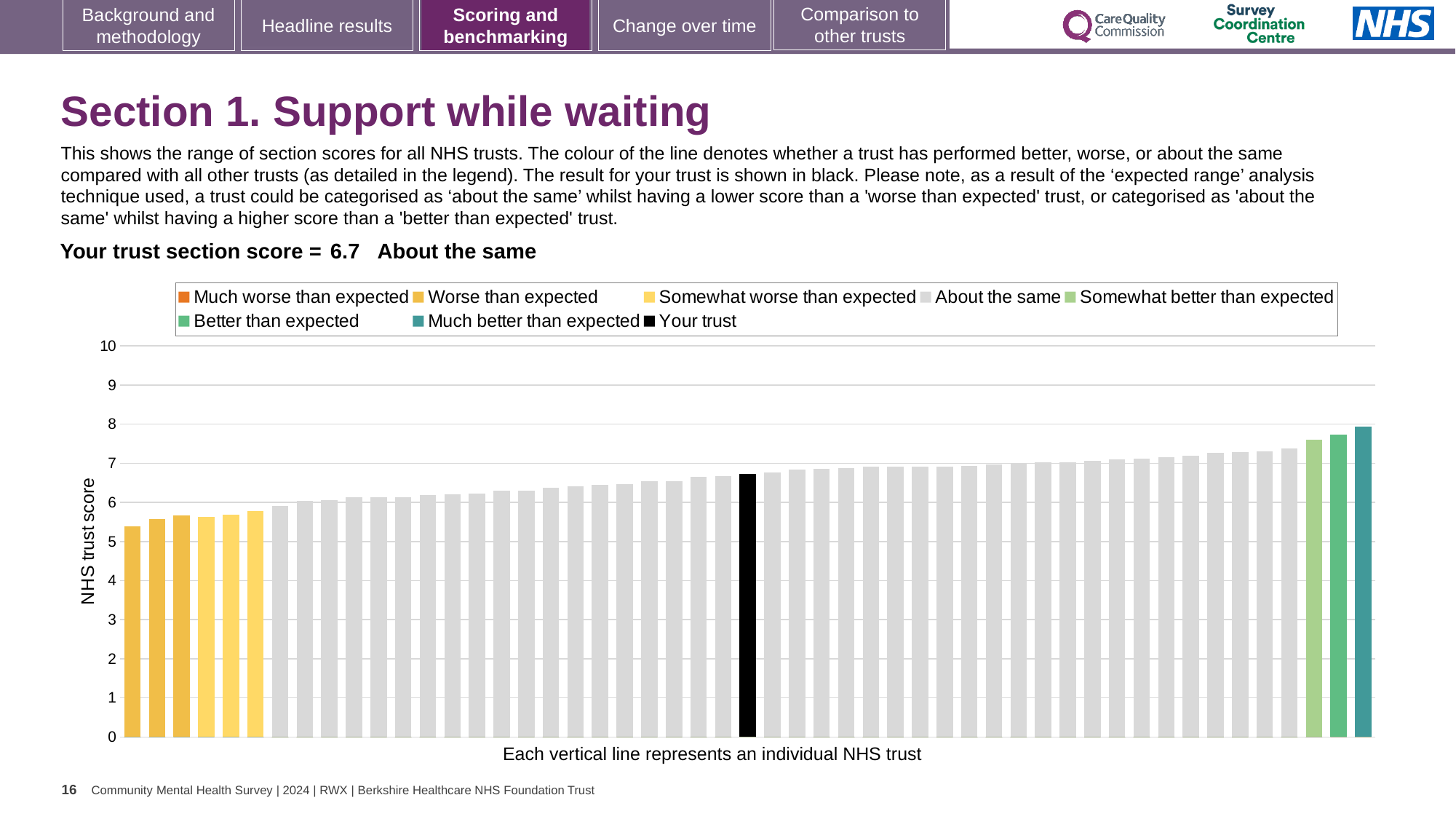
What kind of chart is shown on the slide? Bar chart Which bar has the highest value on the chart? The rightmost bar (Much better than expected) How many entries does the chart legend list? 8 Is the value of the leftmost (lowest) bar greater or less than 5? greater According to the caption below the chart, what does each vertical line represent? An individual NHS trust Which performance category is your trust placed in, according to the text above the chart? About the same What is the section score for your trust, as printed on the slide? 6.7 Is the value of the black bar (your trust) greater or less than 6? greater Is the value of the black bar (your trust) greater or less than 7? less Do the bar values rise or fall from left to right along the x axis? rise What is the label on the vertical axis of the chart? NHS trust score